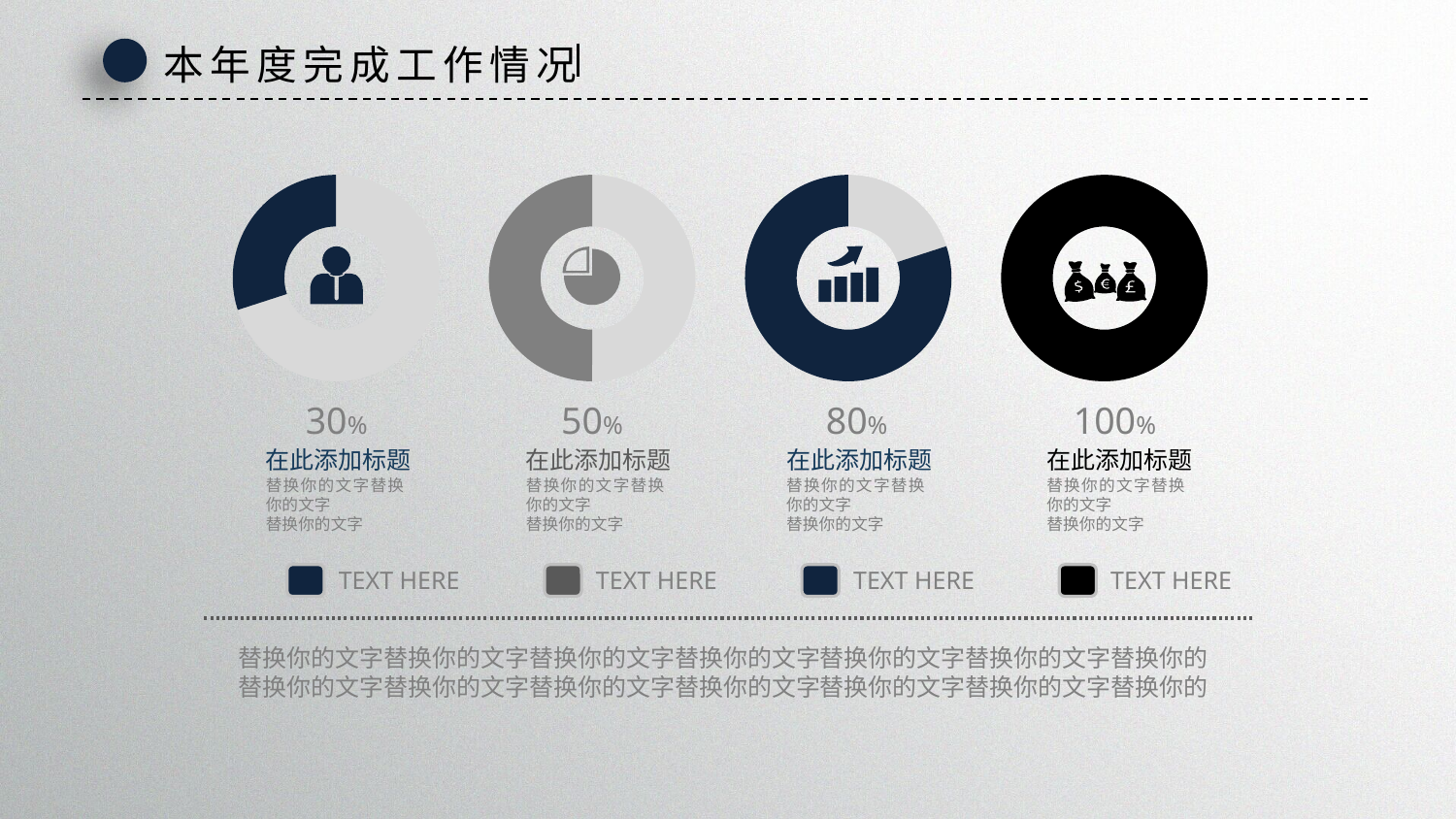
What percentage is shown below the first (leftmost) donut chart? 30% Do the percentages increase or decrease from the leftmost chart to the rightmost chart? Increase How many donut charts are shown on the slide? 4 What percentage is shown below the fourth (rightmost) donut chart? 100% Which is larger, the percentage of the second donut chart or the third donut chart? The third donut chart (80%) Which of the four donut charts shows the highest percentage? The fourth (rightmost), 100% Which of the four donut charts shows the lowest percentage? The first (leftmost), 30% What percentage is shown below the third donut chart from the left? 80% What is the difference between the percentage of the third donut chart and the first donut chart? 50 percentage points What colour is the filled portion of the second donut chart from the left? Grey What kind of chart is used to display the percentages on this slide? Donut (ring) chart What percentage is shown below the second donut chart from the left? 50%